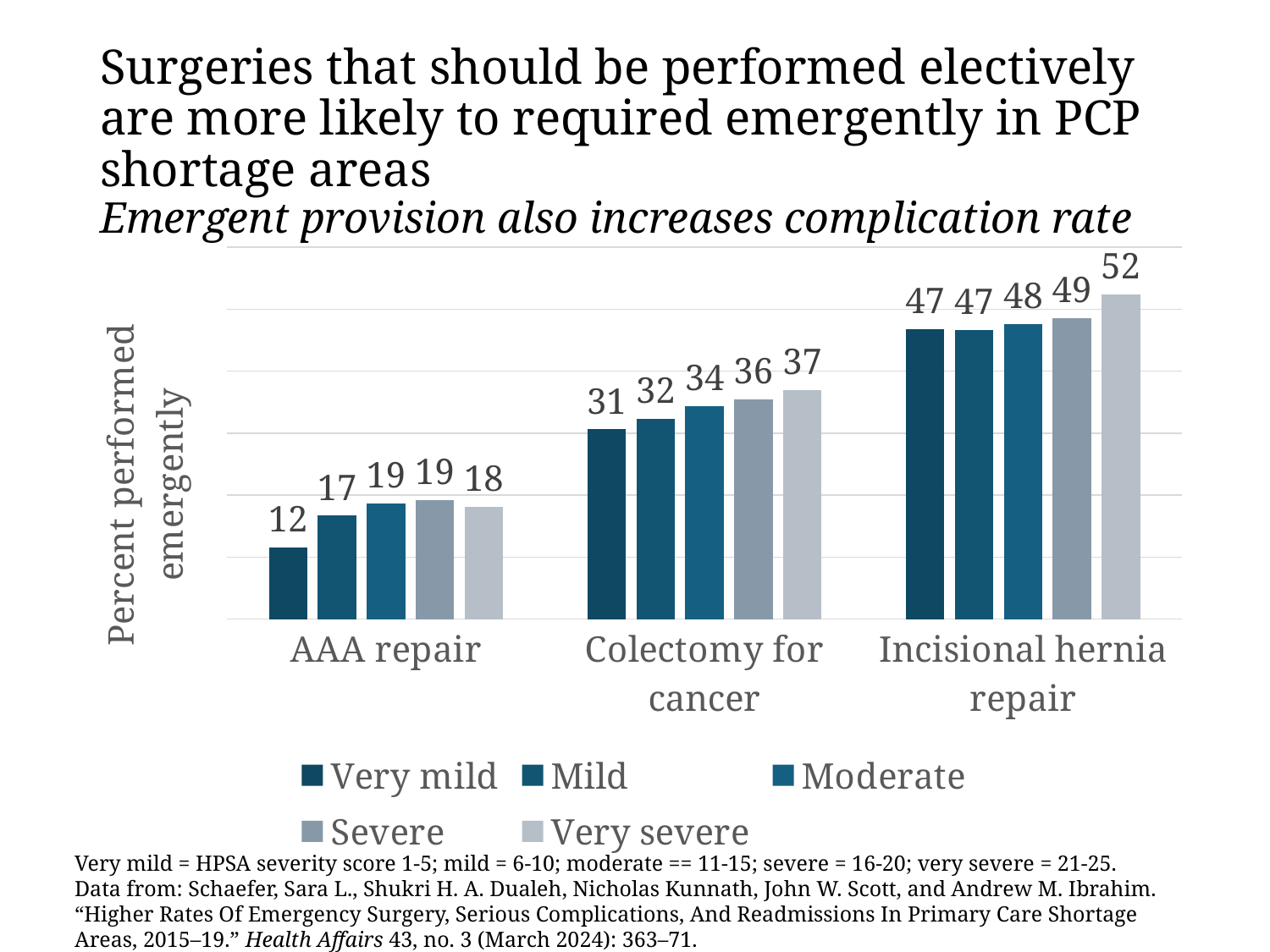
How many series does the legend list? 5 What is the value for Moderate in the Colectomy for cancer category? 34 Which series has the lowest value in the AAA repair category? Very mild What is the value for Very mild in the AAA repair category? 12 What is the y-axis label of the chart? Percent performed emergently Which is larger in the AAA repair category: the Severe value or the Very severe value? Severe What is the value for Very severe in the Incisional hernia repair category? 52 What kind of chart is shown on the slide? Bar chart How many categories are shown on the x axis? 3 What is the difference between the Very severe and Very mild values for Colectomy for cancer? 6 Which category has the highest value for the Very severe series? Incisional hernia repair Do the Very mild values rise or fall from AAA repair to Incisional hernia repair? Rise